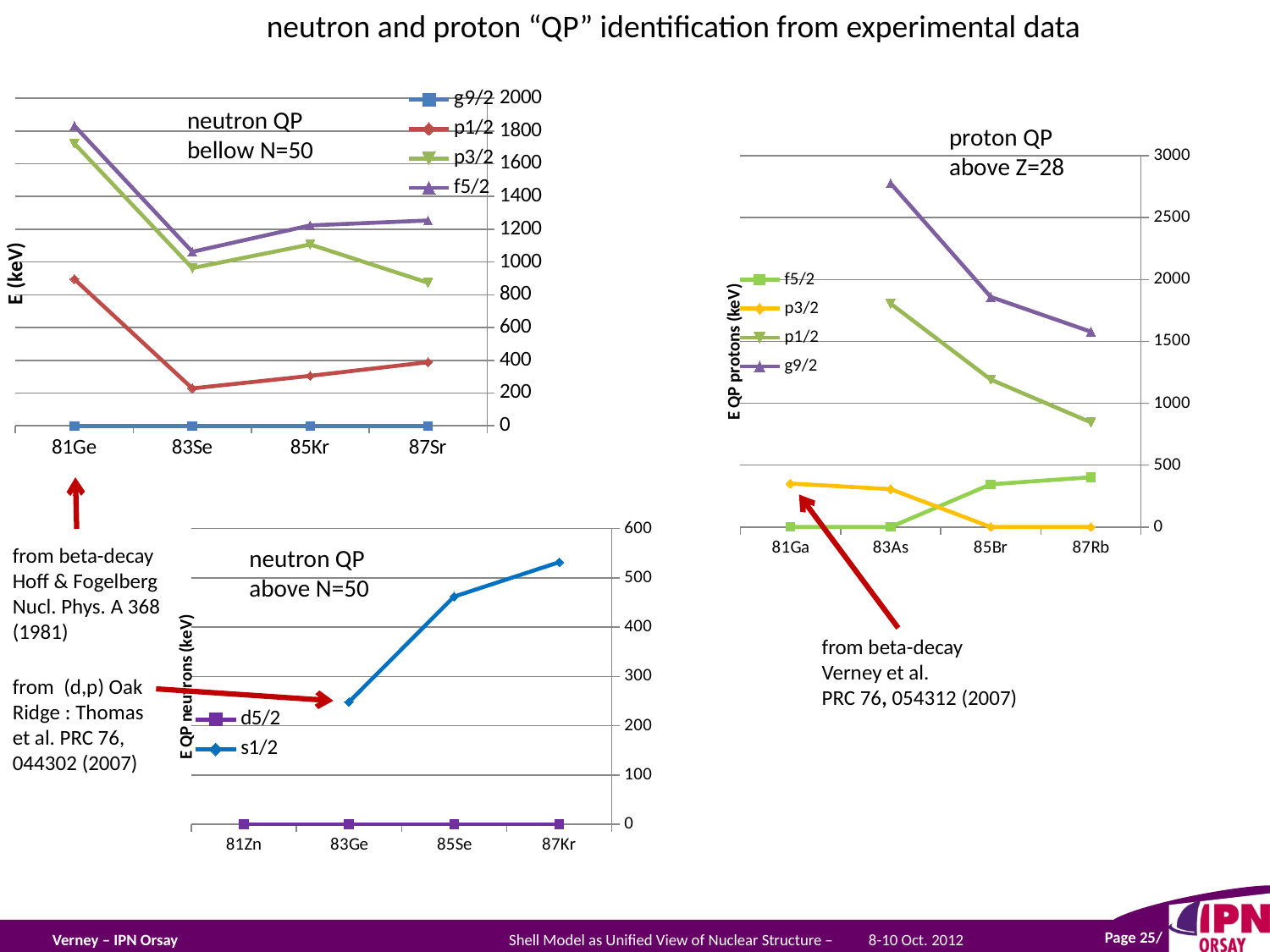
In the "proton QP above Z=28" chart, at which category does the g9/2 series reach its highest value? 83As In the "proton QP above Z=28" chart, is the g9/2 value for 83As greater or less than 2500? greater In the "neutron QP above N=50" chart, does the s1/2 series rise or fall from 83Ge to 87Kr? rise In the "neutron QP bellow N=50" chart, does the p1/2 series rise or fall from 83Se to 87Sr? rise In the "neutron QP above N=50" chart, is the s1/2 value for 87Kr greater or less than 500? greater What kind of chart is the "neutron QP bellow N=50" chart? line chart How many categories are on the x axis of the "neutron QP bellow N=50" chart? 4 How many series does the legend of the "neutron QP bellow N=50" chart list? 4 In the "neutron QP bellow N=50" chart, is the p1/2 value for 83Se greater or less than 400? less How many series does the legend of the "neutron QP above N=50" chart list? 2 In the "proton QP above Z=28" chart, which is larger at 87Rb: the p1/2 value or the f5/2 value? p1/2 In the "neutron QP bellow N=50" chart, which series has the highest value at 81Ge? f5/2